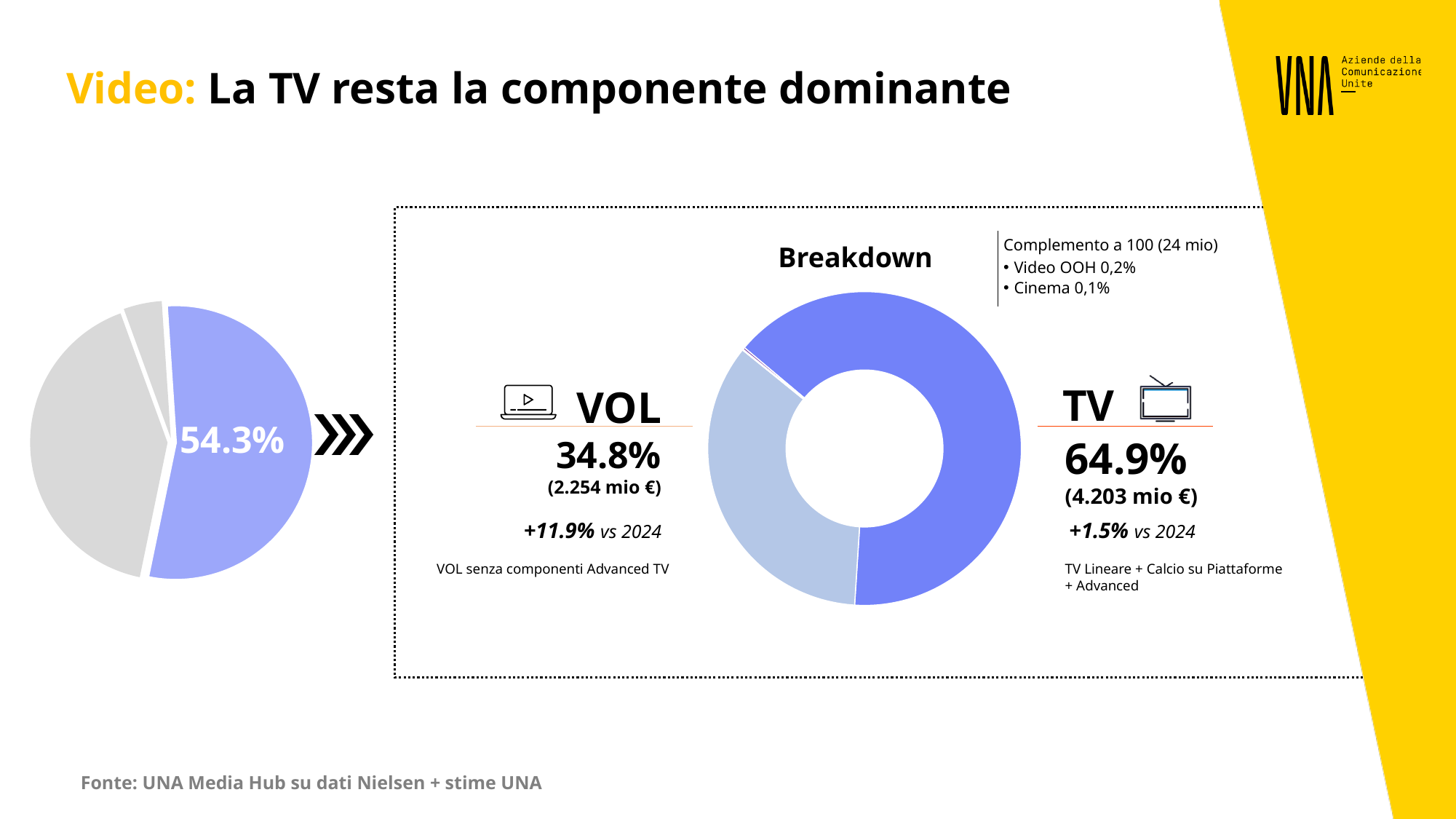
In the Breakdown chart, what is the value in mio € shown for TV? 4.203 mio € In the Breakdown chart, what is the change vs 2024 shown for VOL? +11.9% In the Breakdown chart, what share does TV hold? 64.9% In the left pie chart, what percentage is printed on the highlighted blue slice? 54.3% What kind of chart is the chart on the left of the slide? Pie chart What kind of chart is the Breakdown chart? Donut chart In the Breakdown chart, what is the change vs 2024 shown for TV? +1.5% In the Breakdown chart, what is the difference in percentage points between the TV share and the VOL share? 30.1 percentage points In the Breakdown chart, what share does VOL hold? 34.8% In the Breakdown chart, which component has the smallest share among those listed? Cinema In the Breakdown chart, what is the value in mio € shown for VOL? 2.254 mio € In the Breakdown chart, which component is larger, TV or VOL? TV